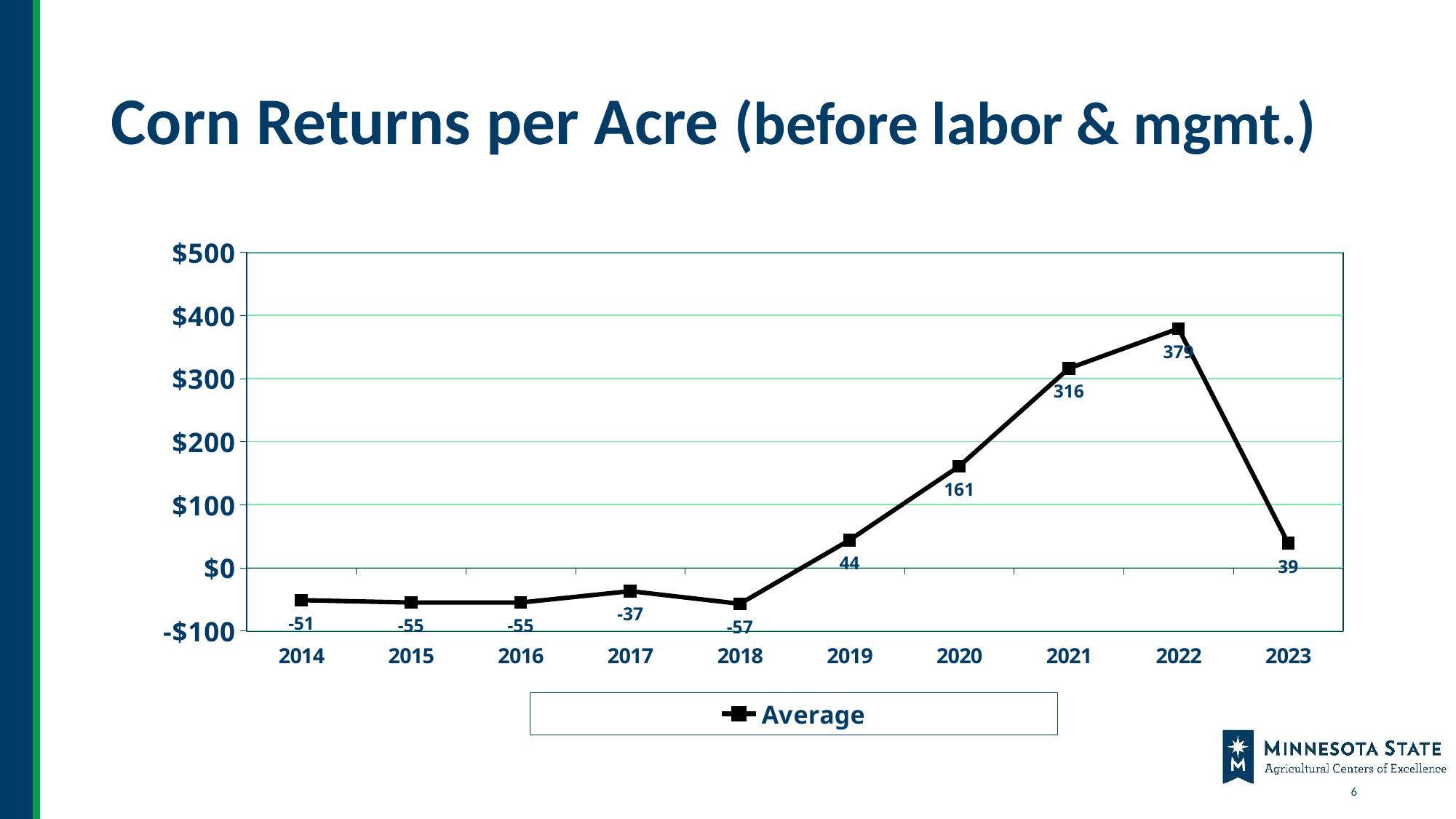
What is the difference between the average corn return per acre in 2021 and in 2020? 155 What is the average corn return per acre in 2023? 39 What is the name of the series shown in the legend? Average Which year has a larger average corn return per acre, 2019 or 2023? 2019 What is the average corn return per acre in 2020? 161 What is the average corn return per acre in 2018? -57 Which year has the lowest average corn return per acre? 2018 What kind of chart is shown on the slide? line chart Is the value for 2022 greater or less than $300? greater How many series does the legend list? 1 How many years are plotted on the x axis? 10 Which year has the highest average corn return per acre? 2022